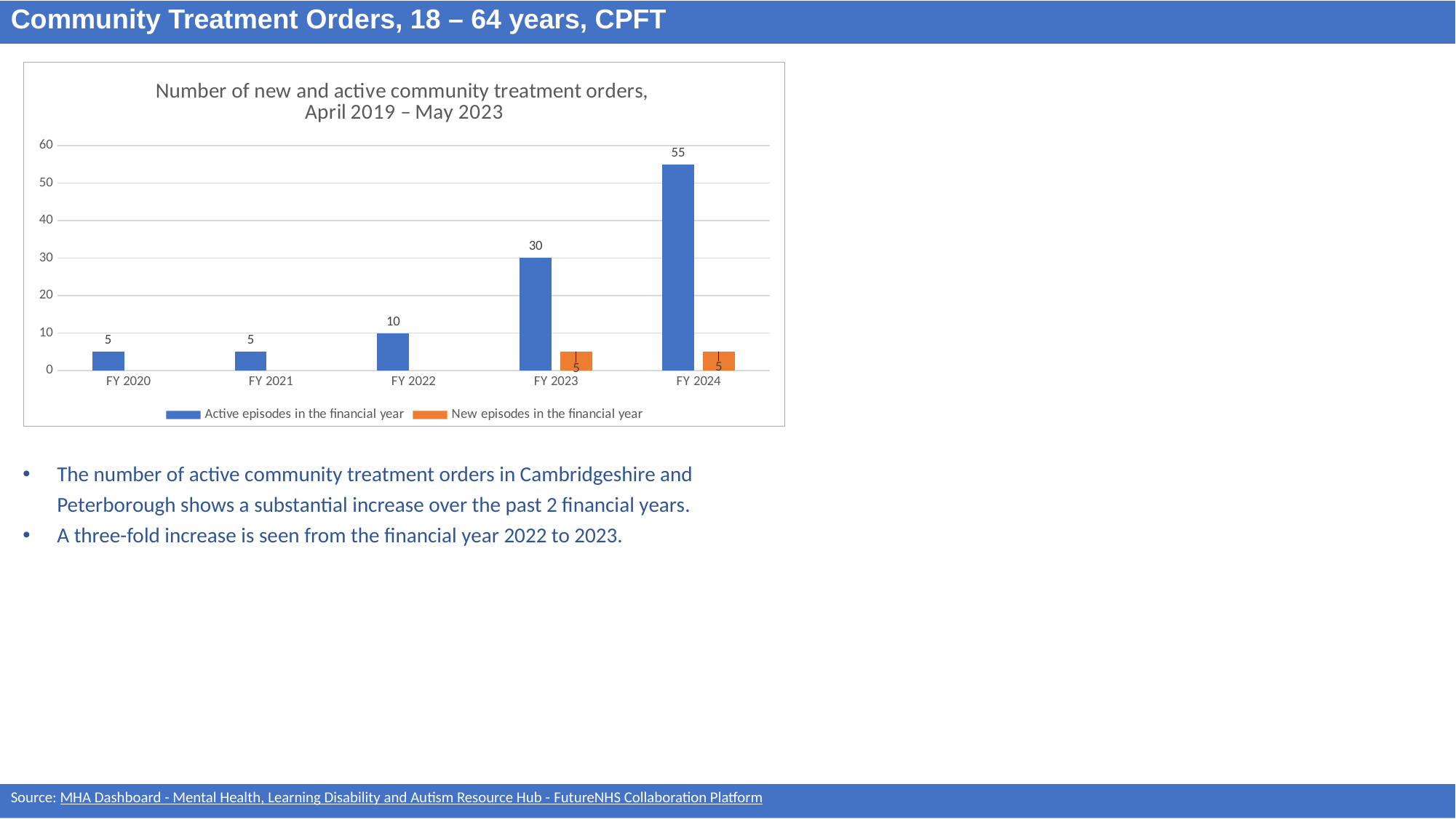
How many series does the legend list? 2 Which financial year has the highest value for Active episodes in the financial year? FY 2024 Do the values for Active episodes in the financial year rise or fall from FY 2020 to FY 2024? Rise What is the value for Active episodes in the financial year in FY 2024? 55 What kind of chart is shown on the slide? Bar chart What is the difference between Active episodes in the financial year in FY 2024 and FY 2023? 25 What is the difference between Active episodes in the financial year in FY 2023 and FY 2022? 20 What is the value for Active episodes in the financial year in FY 2022? 10 Which is larger: Active episodes in the financial year in FY 2023 or in FY 2021? FY 2023 Is the value for Active episodes in the financial year in FY 2024 greater or less than 50? greater What is the value for New episodes in the financial year in FY 2023? 5 How many financial years are shown on the x axis? 5